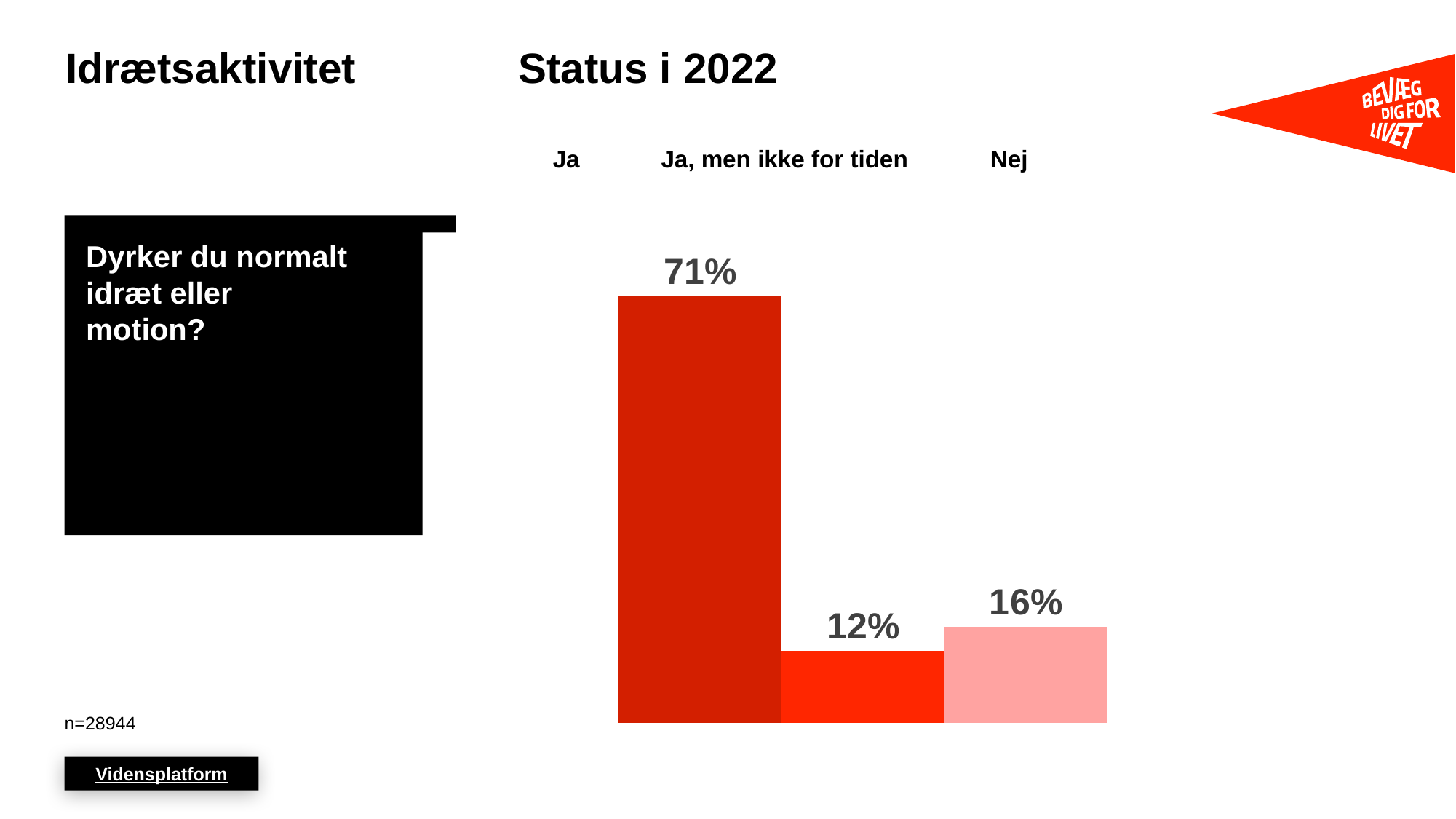
What is the difference in percentage points between "Ja" and "Nej"? 55 What percentage of respondents answered "Ja, men ikke for tiden"? 12% What type of chart is shown on the slide? Bar chart What is the title shown above the chart? Status i 2022 Which is larger, the value for "Nej" or the value for "Ja, men ikke for tiden"? Nej What percentage of respondents answered "Nej"? 16% What is the sample size (n) stated on the slide? n=28944 Which response category has the highest value in the chart? Ja What is the difference in percentage points between "Nej" and "Ja, men ikke for tiden"? 4 Which response category has the lowest value in the chart? Ja, men ikke for tiden How many response categories are shown in the chart? 3 What percentage of respondents answered "Ja" to the question "Dyrker du normalt idræt eller motion?"? 71%